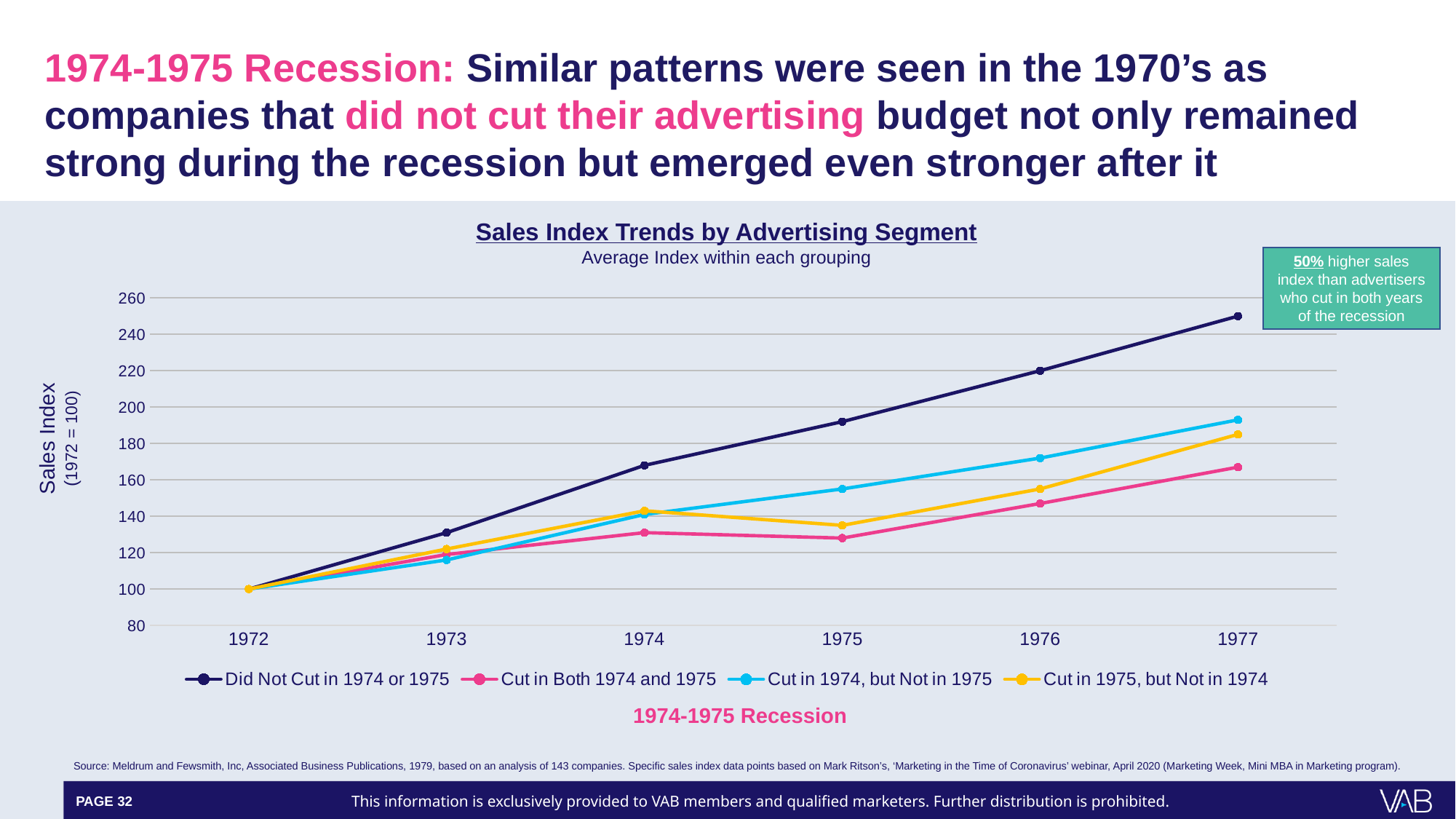
Which segment has the highest sales index in 1977? Did Not Cut in 1974 or 1975 Is the 1977 value for 'Did Not Cut in 1974 or 1975' greater or less than 240? greater Is the 1975 value for 'Cut in Both 1974 and 1975' greater or less than 140? less What is the sales index value for all four segments in 1972? 100 According to the callout box, how much higher is the sales index of advertisers who did not cut compared with those who cut in both years of the recession? 50% How many series does the legend list? 4 In 1976, which is larger: the value for 'Cut in 1974, but Not in 1975' or 'Cut in 1975, but Not in 1974'? Cut in 1974, but Not in 1975 What is the title of the chart? Sales Index Trends by Advertising Segment Which segment has the lowest sales index in 1977? Cut in Both 1974 and 1975 How many years are plotted along the x axis? 6 What kind of chart is shown on the slide? line chart Does the sales index for 'Did Not Cut in 1974 or 1975' rise or fall from 1972 to 1977? rise